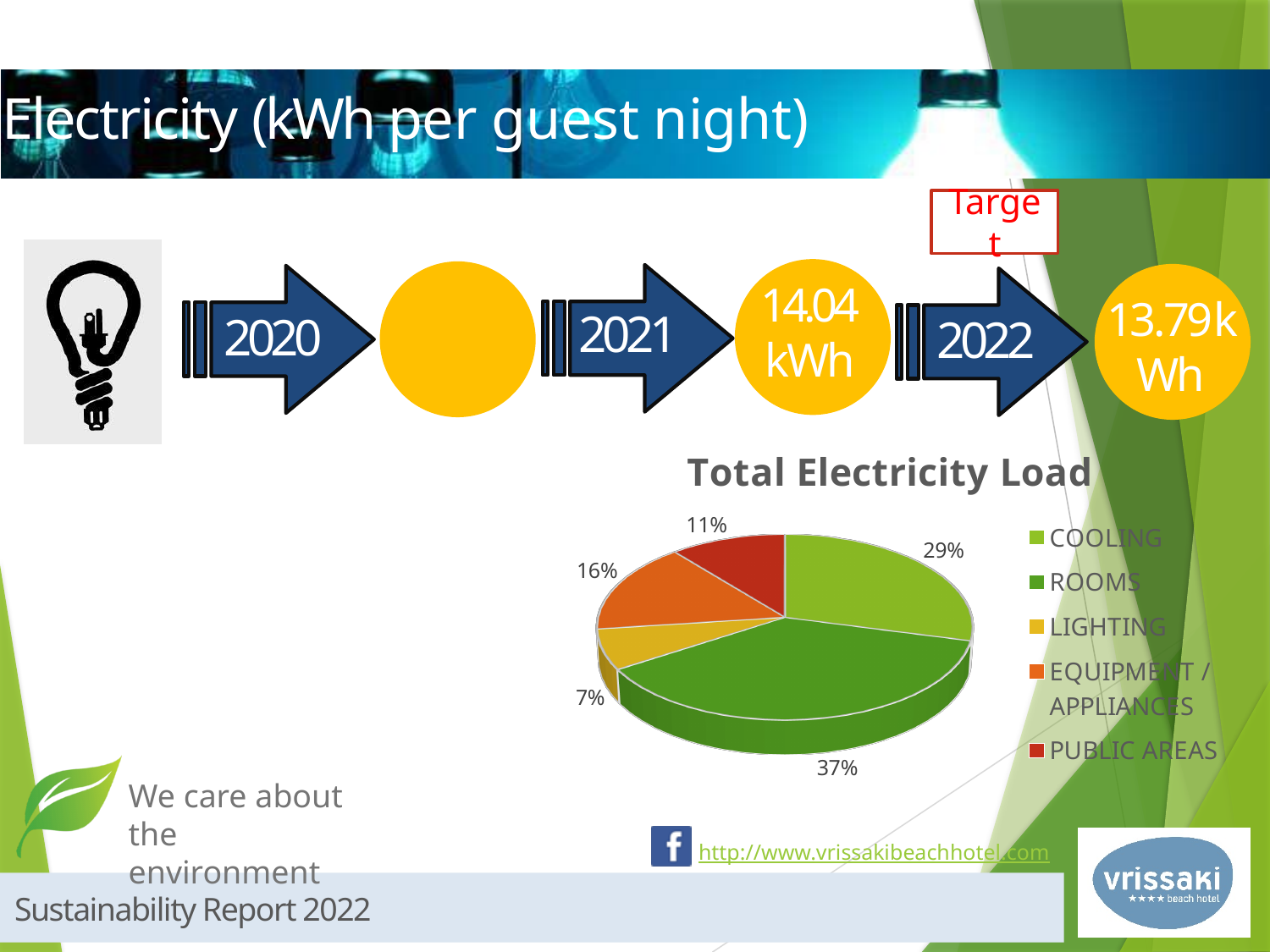
What is the title of the chart on the slide? Total Electricity Load In the Total Electricity Load chart, which is larger: EQUIPMENT / APPLIANCES or PUBLIC AREAS? EQUIPMENT / APPLIANCES In the Total Electricity Load chart, what share do PUBLIC AREAS represent? 11% In the Total Electricity Load chart, what is the share for LIGHTING? 7% In the Total Electricity Load chart, what share does ROOMS account for? 37% In the Total Electricity Load chart, what percentage is shown for COOLING? 29% Which category has the smallest share in the Total Electricity Load chart? LIGHTING In the Total Electricity Load chart, what is the difference in percentage points between ROOMS and COOLING? 8 How many categories are shown in the Total Electricity Load chart? 5 Which category has the largest share in the Total Electricity Load chart? ROOMS What type of chart is the Total Electricity Load chart? Pie chart In the Total Electricity Load chart, what percentage is attributed to EQUIPMENT / APPLIANCES? 16%